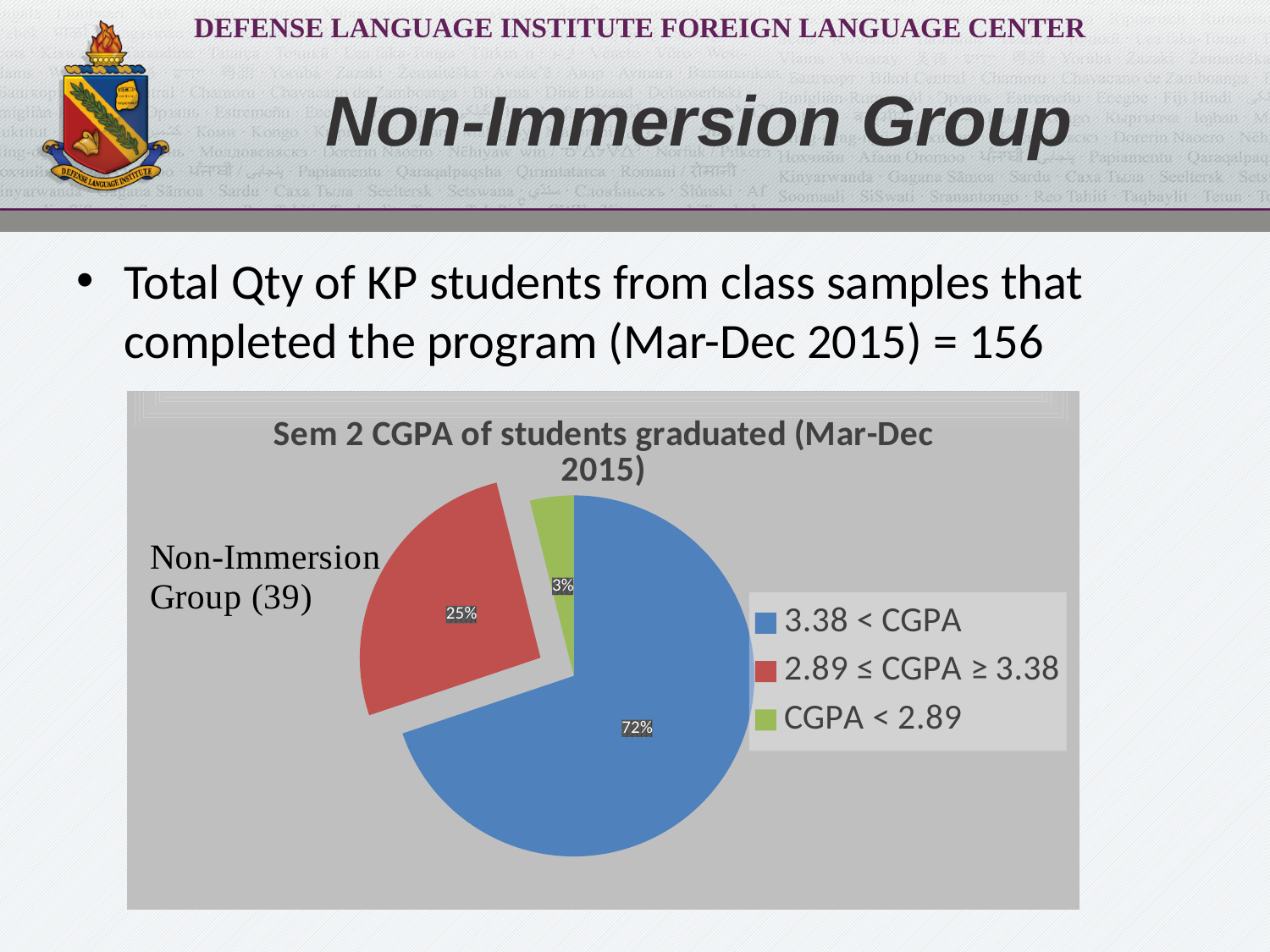
What percentage of the pie is the slice for 3.38 < CGPA? 72% What is the difference in percentage points between the 3.38 < CGPA slice and the 2.89 ≤ CGPA ≥ 3.38 slice? 47% Which slice is larger: 2.89 ≤ CGPA ≥ 3.38 or CGPA < 2.89? 2.89 ≤ CGPA ≥ 3.38 Which category has the largest slice of the pie? 3.38 < CGPA How many entries does the legend list? 3 What percentage of the pie is the slice for 2.89 ≤ CGPA ≥ 3.38? 25% What colour is the slice for CGPA < 2.89? Green How many slices does the pie chart have? 3 What is the title of the chart? Sem 2 CGPA of students graduated (Mar-Dec 2015) What percentage of the pie is the slice for CGPA < 2.89? 3% Which category has the smallest slice of the pie? CGPA < 2.89 What kind of chart is shown on the slide? Pie chart